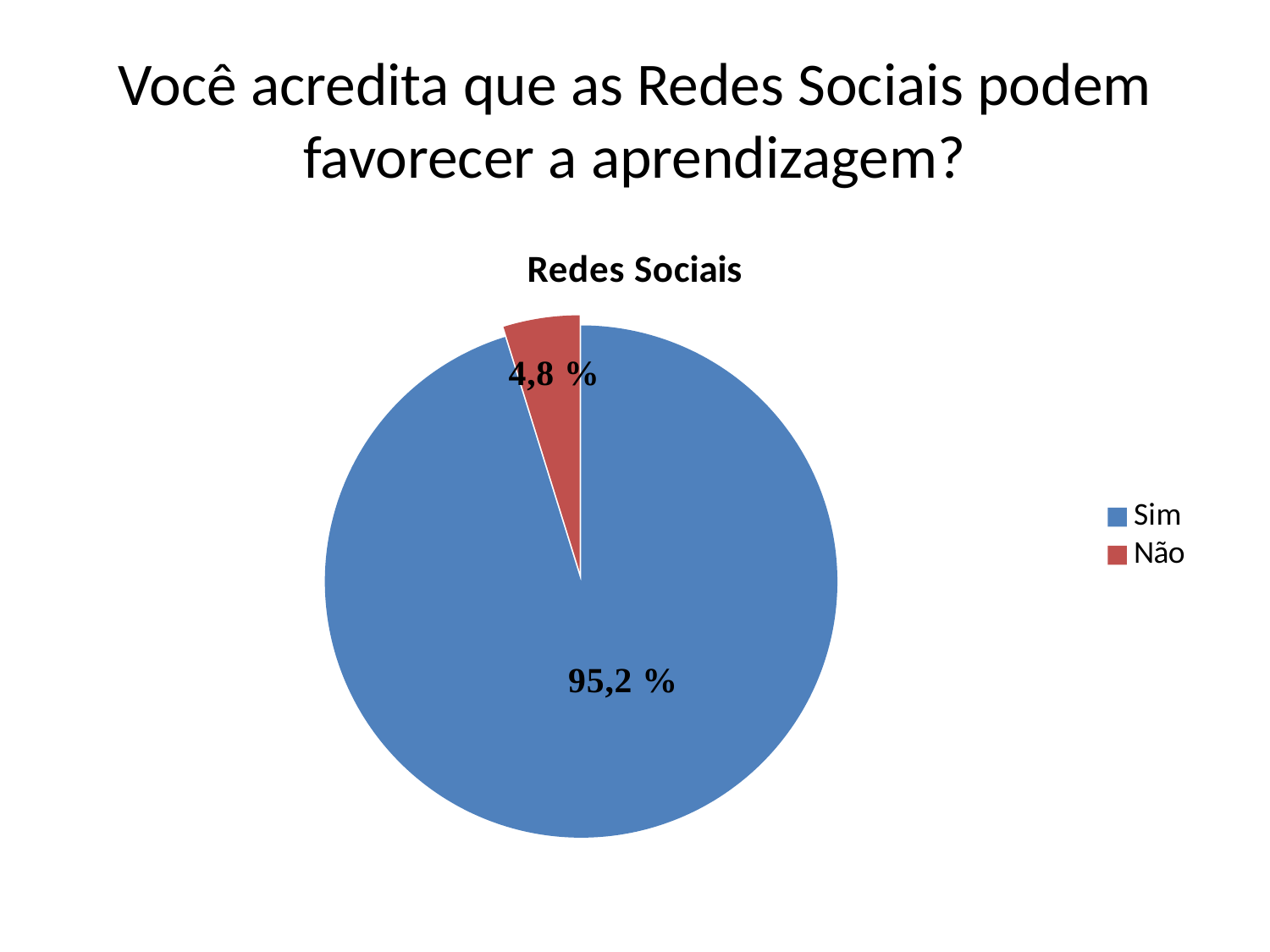
How many entries does the legend list? 2 What is the difference in percentage points between the 'Sim' and 'Não' slices? 90,4 % How many slices does the pie chart have? 2 Which slice is the largest in the pie chart? Sim What is the title of the chart? Redes Sociais What colour is the 'Não' slice in the pie chart? red Which slice is the smallest in the pie chart? Não Which is larger, the 'Sim' slice or the 'Não' slice? Sim Is the value for 'Sim' greater or less than 50%? greater What share of the pie does the 'Sim' slice represent? 95,2 % What share of the pie does the 'Não' slice represent? 4,8 % What kind of chart is shown on the slide? pie chart